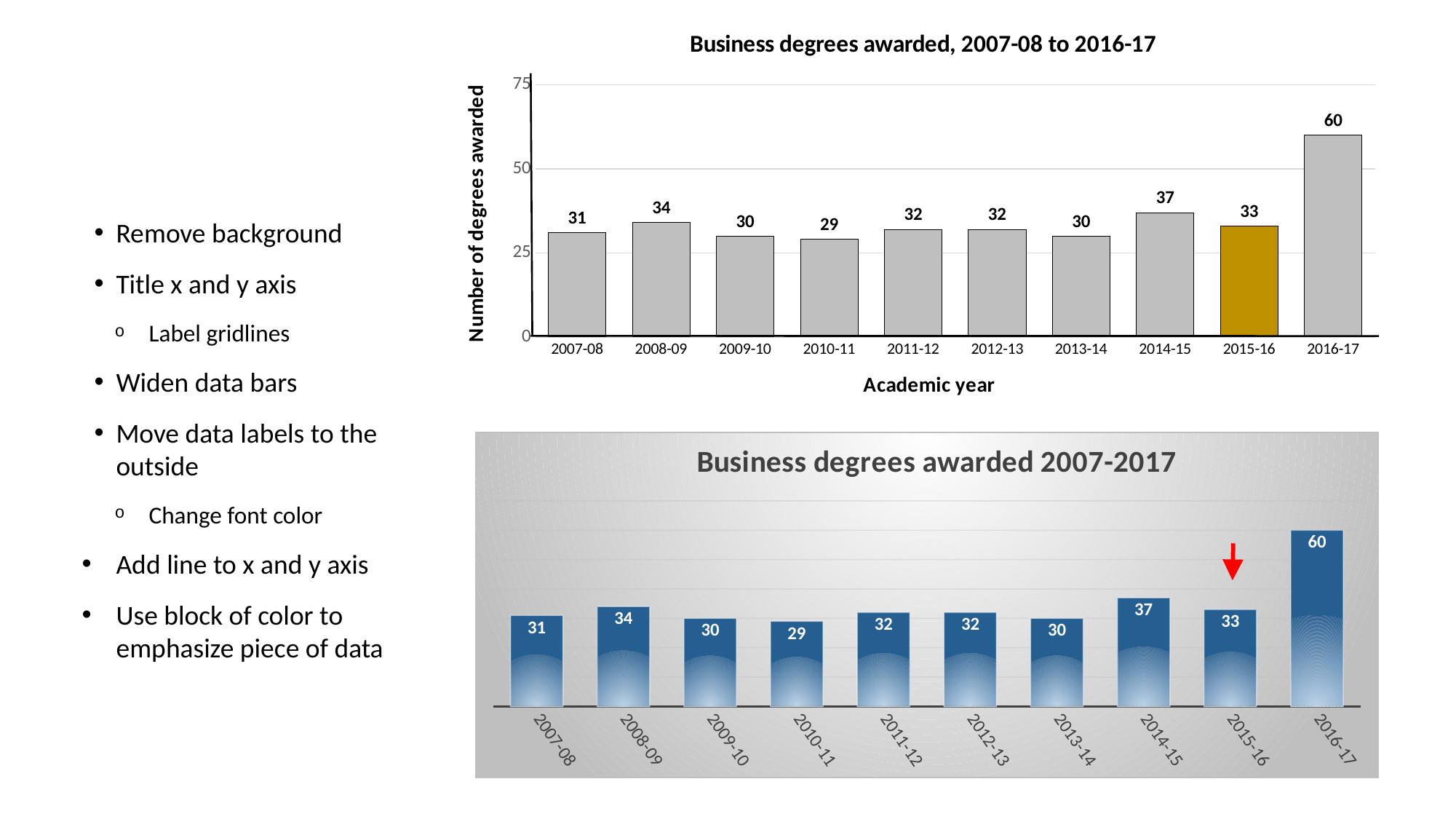
In the top chart, which academic year has the highest number of degrees awarded? 2016-17 In the top chart, which bar is highlighted in a different color (gold) from the others? 2015-16 In the bottom chart titled 'Business degrees awarded 2007-2017', what is the value for 2011-12? 32 In the top chart, which year had more degrees awarded, 2008-09 or 2013-14? 2008-09 In the bottom chart, what is the value for 2015-16, the bar marked with a red arrow? 33 What kind of chart is the bottom chart titled 'Business degrees awarded 2007-2017'? bar chart In the top chart titled 'Business degrees awarded, 2007-08 to 2016-17', how many degrees were awarded in 2014-15? 37 In the top chart, what is the difference between the degrees awarded in 2016-17 and 2015-16? 27 What is the y-axis title of the top chart? Number of degrees awarded How many academic years are shown in the top chart? 10 In the top chart, is the value for 2016-17 greater or less than 50? greater In the top chart, which academic year has the lowest number of degrees awarded? 2010-11